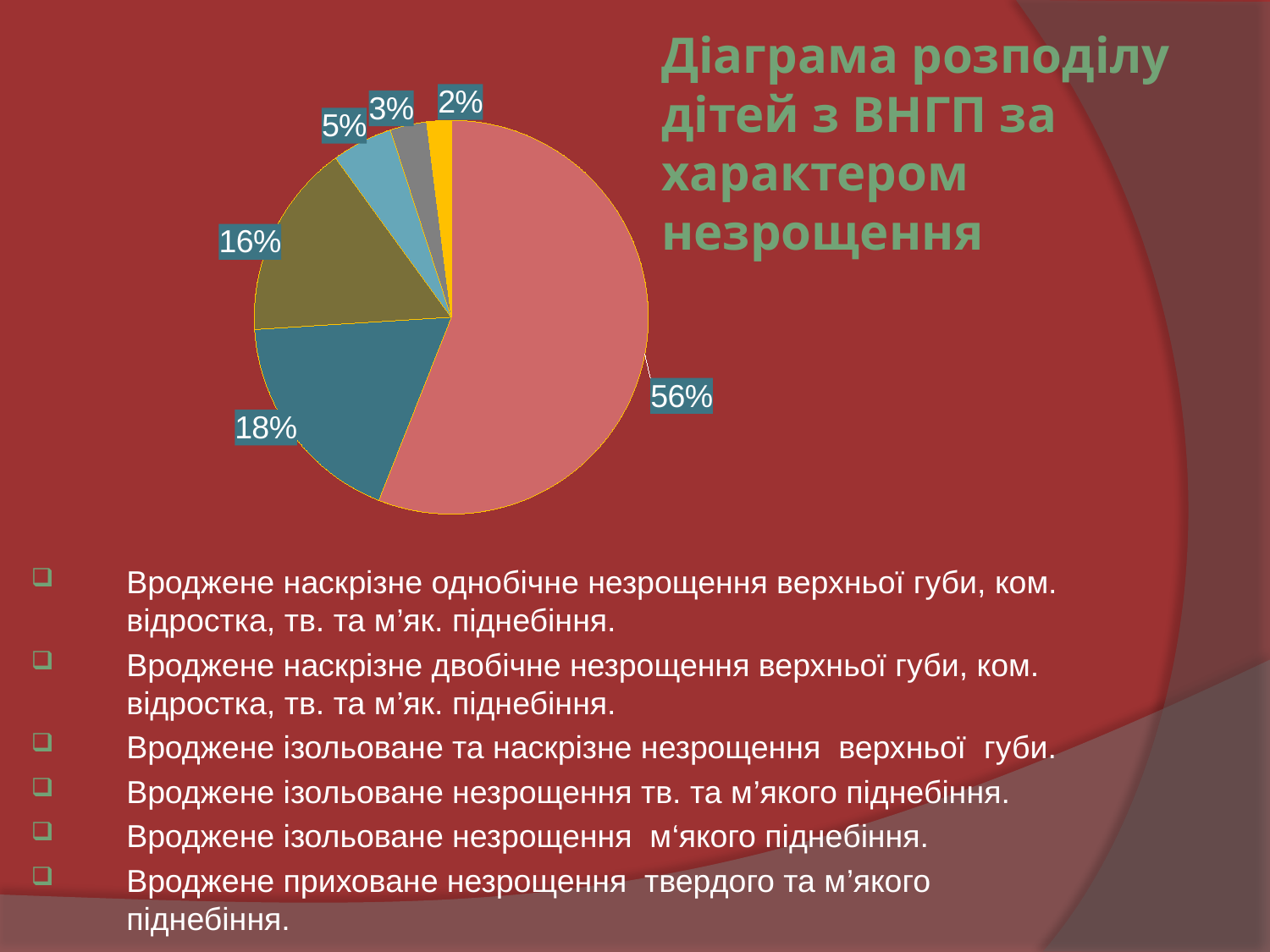
What is the value of the grey slice of the pie chart? 3% What is the title of the chart on the slide? Діаграма розподілу дітей з ВНГП за характером незрощення What is the value of the smallest slice of the pie chart? 2% What is the difference between the 18% slice and the 16% slice? 2 percentage points Which is larger, the dark teal slice or the olive slice? the dark teal slice (18%) What is the difference between the largest slice (56%) and the second-largest slice (18%)? 38 percentage points What share of the pie does the large pink slice represent? 56% What is the value of the yellow slice of the pie chart? 2% What is the combined share of the three smallest slices (5%, 3% and 2%)? 10% What type of chart is shown on the slide? pie chart What is the value of the largest slice of the pie chart? 56% How many slices does the pie chart have? 6